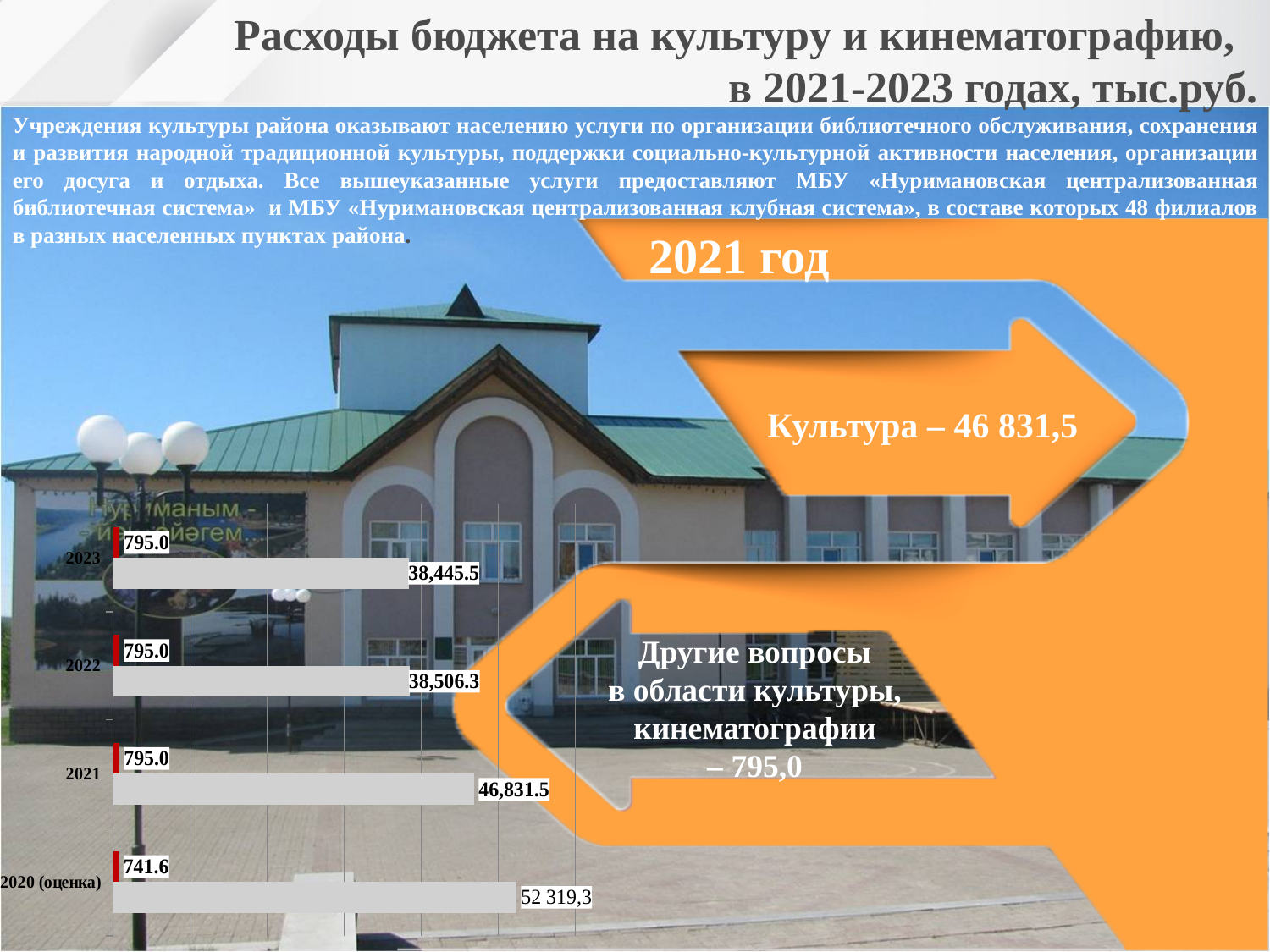
Which year has the highest value for the large grey bar? 2020 (оценка) What type of chart is shown on the slide? bar chart What is the value of the small red bar for 2020 (оценка)? 741.6 What is the value of the large grey bar for 2020 (оценка)? 52 319,3 What is the value of the large grey bar for 2023? 38,445.5 Which is larger: the large grey bar for 2022 or for 2023? 2022 Do the large grey bar values rise or fall from 2020 (оценка) to 2023? fall What is the total of the two bars for 2021? 47,626.5 What is the value of the large grey bar for 2021? 46,831.5 Which year has the lowest value for the small red bar? 2020 (оценка) How many year categories does the chart show? 4 What is the difference between the large grey bar values for 2021 and 2022? 8,325.2